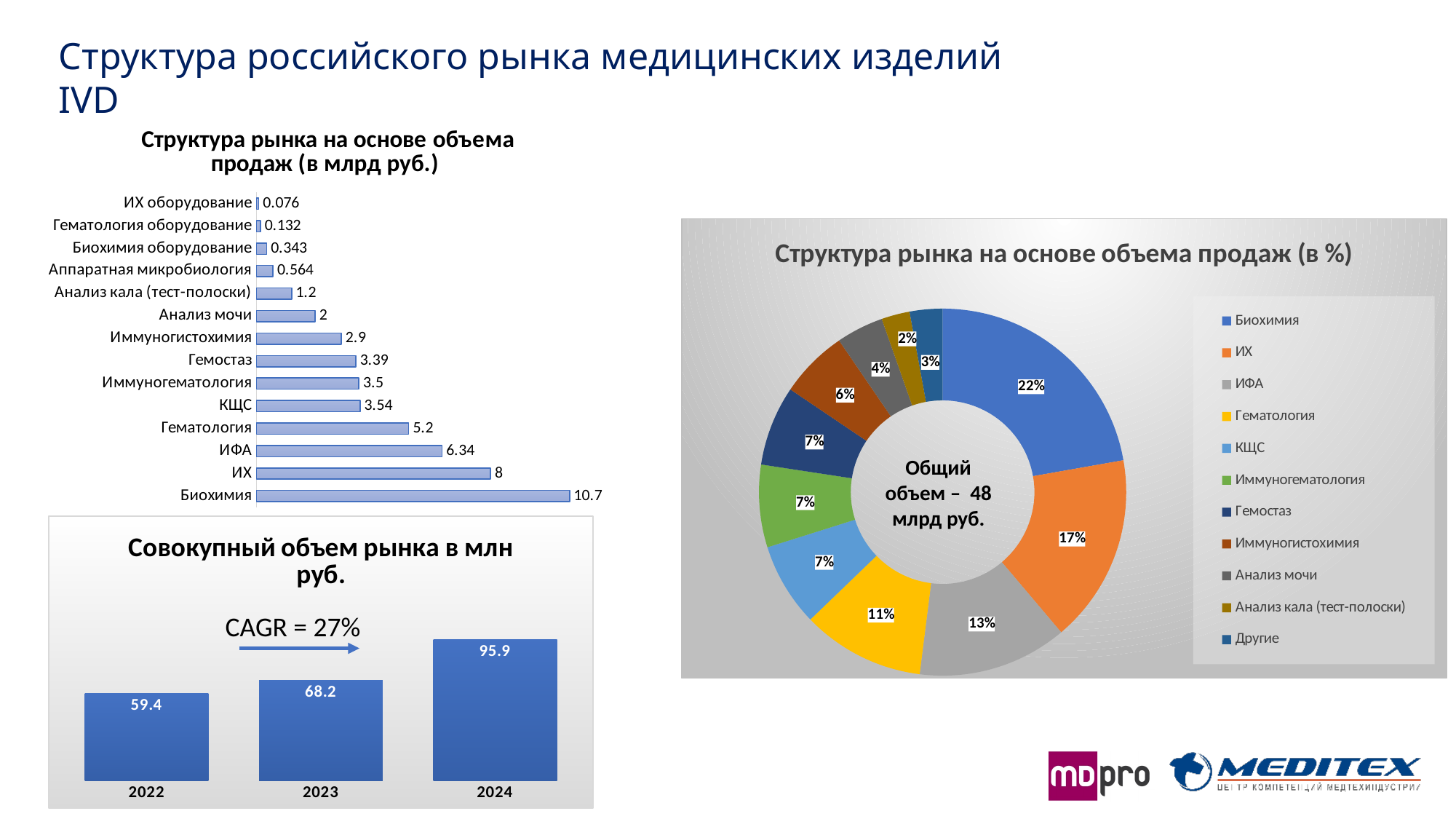
In the chart 'Структура рынка на основе объема продаж (в млрд руб.)', what is the value for Биохимия? 10.7 In the chart 'Структура рынка на основе объема продаж (в %)', which category has the largest share? Биохимия In the chart 'Совокупный объем рынка в млн руб.', what CAGR is shown? 27% In the chart 'Структура рынка на основе объема продаж (в млрд руб.)', how many categories are shown? 14 In the chart 'Совокупный объем рынка в млн руб.', what is the value for 2023? 68.2 In the chart 'Совокупный объем рынка в млн руб.', do the values rise or fall from 2022 to 2024? rise In the chart 'Структура рынка на основе объема продаж (в %)', what share does ИФА have? 13% In the chart 'Структура рынка на основе объема продаж (в млрд руб.)', which category has the lowest value? ИХ оборудование In the chart 'Совокупный объем рынка в млн руб.', what is the difference between the 2024 and 2022 values? 36.5 In the chart 'Структура рынка на основе объема продаж (в млрд руб.)', what is the difference between the values for ИХ and ИФА? 1.66 In the chart 'Структура рынка на основе объема продаж (в %)', how many entries does the legend list? 11 In the chart 'Структура рынка на основе объема продаж (в млрд руб.)', what is the value for Гемостаз? 3.39